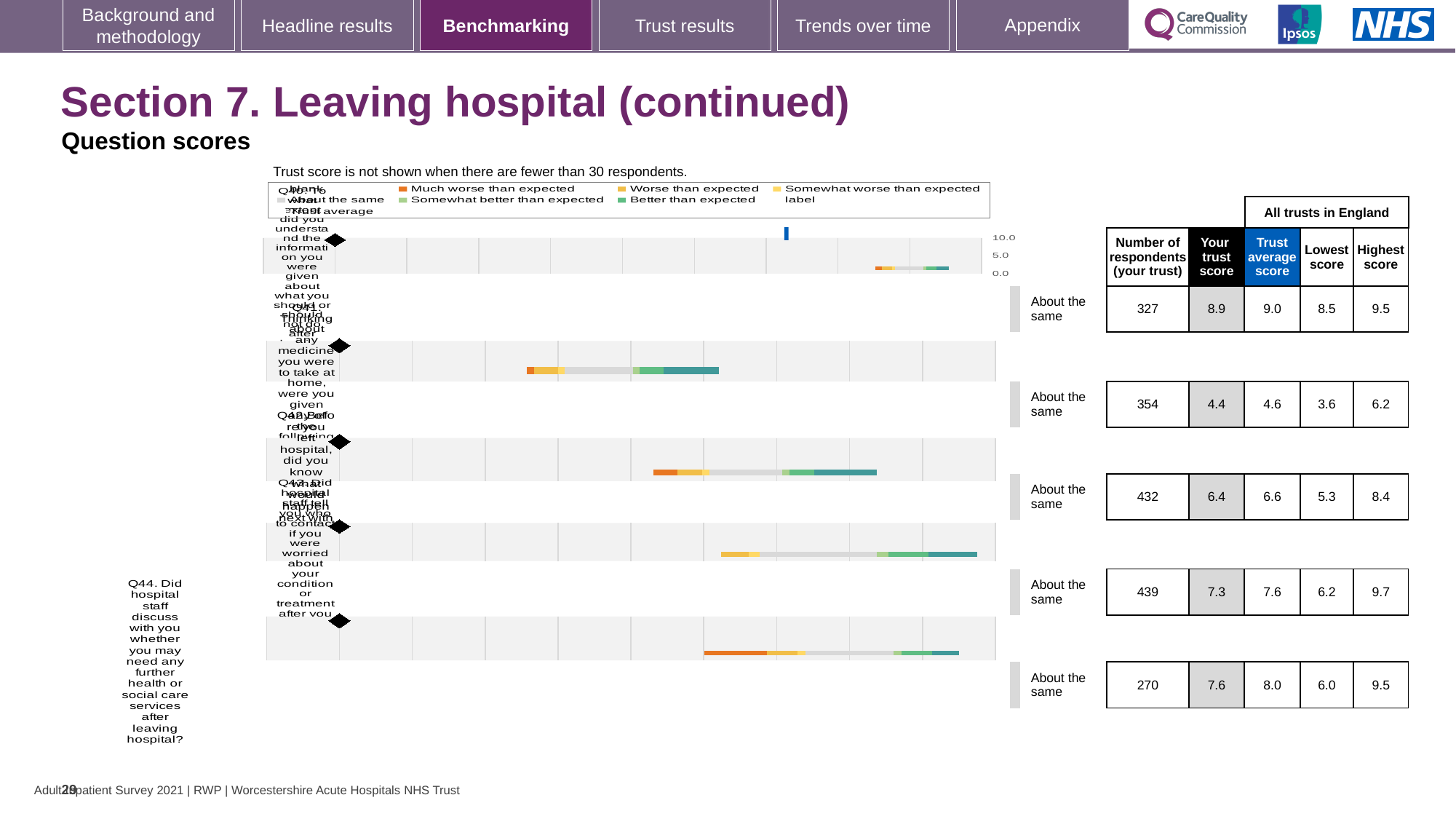
What type of chart is used to show the question scores? Bar chart For Q44, what is the difference between the trust average score and your trust score? 0.4 How many questions are plotted on this slide? 5 What comparison category is shown for every question on this slide? About the same What is the trust score for Q44 (Did hospital staff discuss with you whether you may need any further health or social care services after leaving hospital?)? 7.6 Which has the larger 'Your trust score': Q42 or Q43? Q43 Which question has the highest 'Your trust score' on this slide? Q40 How many respondents from the trust answered Q44? 270 Which question has the lowest 'Your trust score' on this slide? Q41 What is the lowest score across all trusts in England for Q42? 5.3 What is the highest score across all trusts in England for Q43? 9.7 What is the trust average score for Q41? 4.6